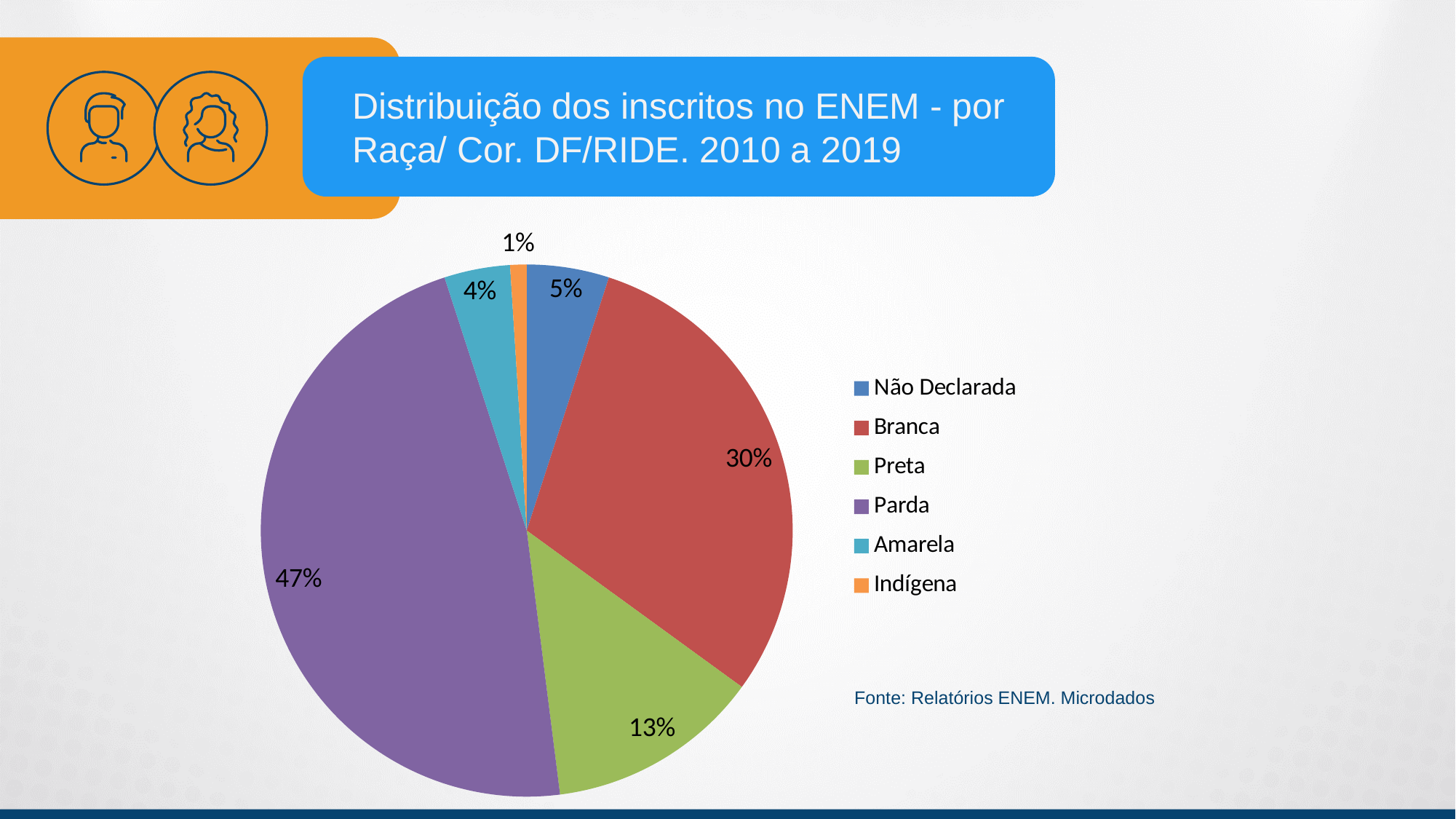
What is the value shown for Indígena? 1% What is the value shown for Preta? 13% Which category has the largest slice of the pie? Parda Which is larger, the share for Preta or the share for Não Declarada? Preta What share of the pie does Branca represent? 30% What is the value shown for Não Declarada? 5% What kind of chart is shown on the slide? pie chart What is the difference between the shares of Parda and Branca? 17% Which category has the smallest slice of the pie? Indígena What is the value shown for Amarela? 4% How many categories does the legend list? 6 What share of the pie does Parda represent? 47%